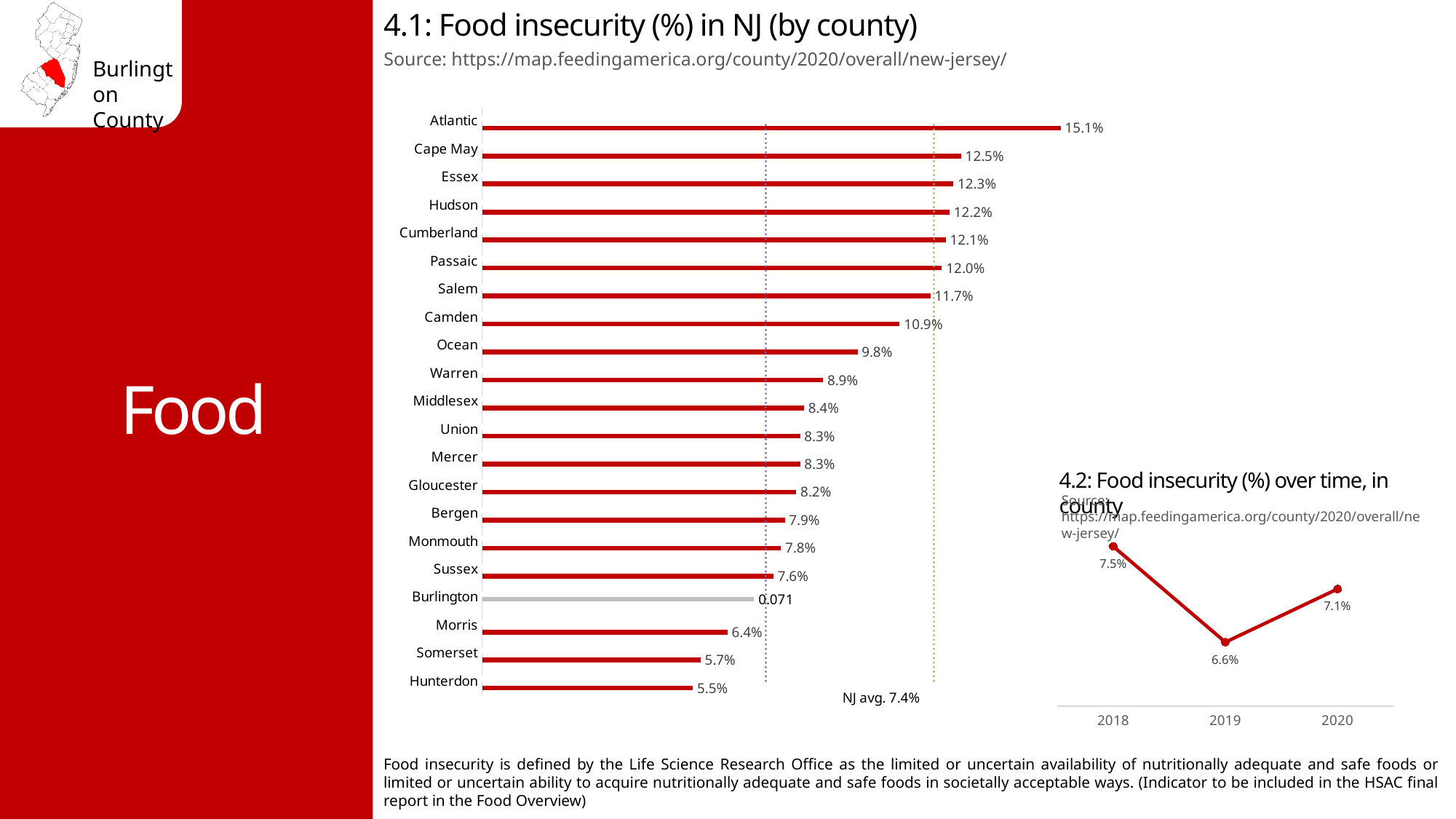
In chart 4.1 (Food insecurity (%) in NJ by county), which county has the highest food insecurity rate? Atlantic In chart 4.1 (Food insecurity (%) in NJ by county), what NJ average value is labelled on the chart? 7.4% In chart 4.2 (Food insecurity (%) over time, in county), which year has the lowest food insecurity rate? 2019 In chart 4.1 (Food insecurity (%) in NJ by county), how many counties are shown? 21 In chart 4.1 (Food insecurity (%) in NJ by county), what is the food insecurity rate for Somerset? 5.7% In chart 4.1 (Food insecurity (%) in NJ by county), what kind of chart is used? bar chart In chart 4.1 (Food insecurity (%) in NJ by county), which has the higher food insecurity rate, Ocean or Warren? Ocean In chart 4.1 (Food insecurity (%) in NJ by county), how much higher is Atlantic's rate than Cape May's? 2.6% In chart 4.2 (Food insecurity (%) over time, in county), what kind of chart is used? line chart In chart 4.2 (Food insecurity (%) over time, in county), what is the food insecurity rate in 2020? 7.1% In chart 4.1 (Food insecurity (%) in NJ by county), what is the food insecurity rate for Camden? 10.9% In chart 4.1 (Food insecurity (%) in NJ by county), which county has the lowest food insecurity rate? Hunterdon